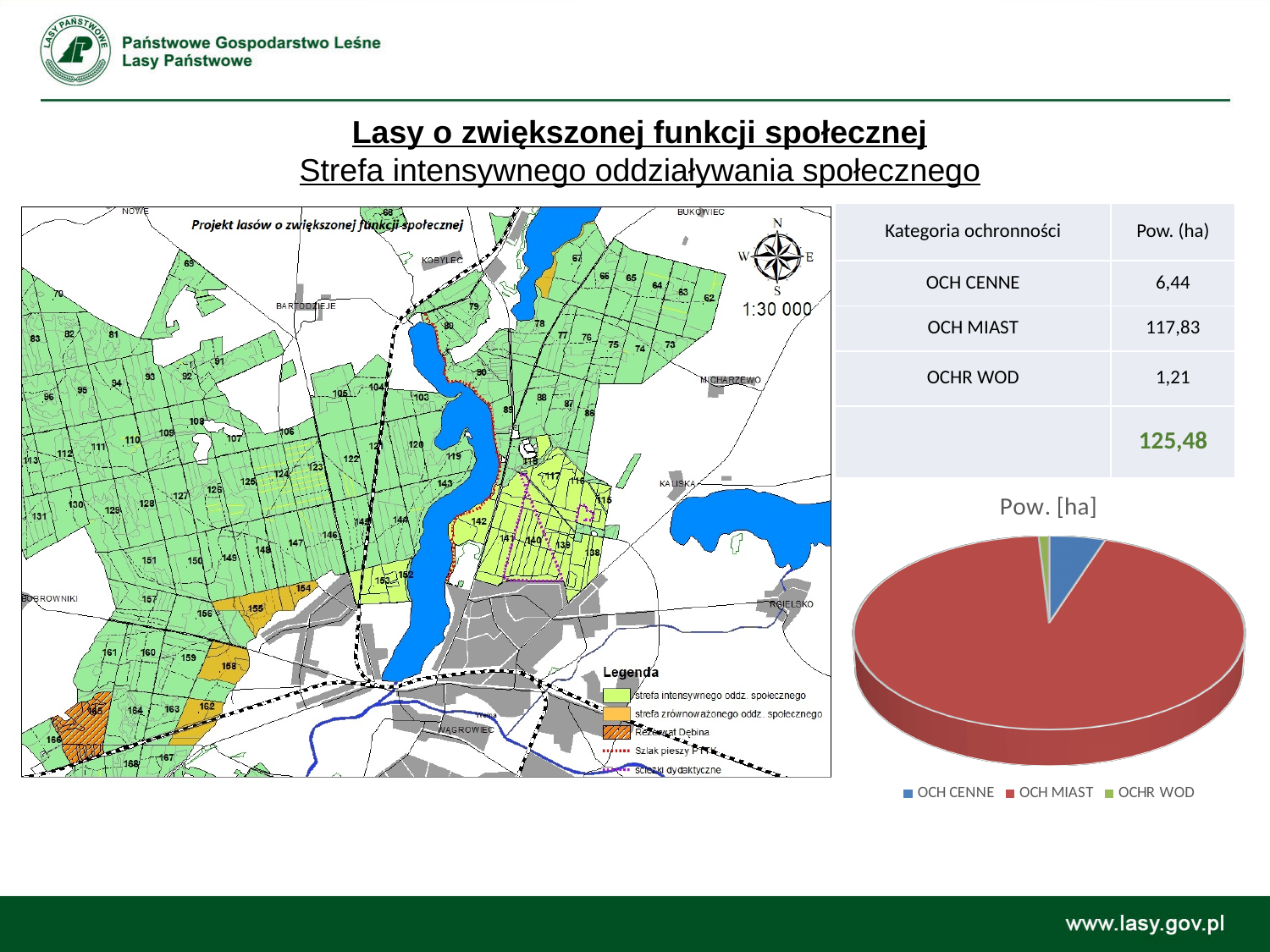
What is the total area (Pow. ha) of all three categories shown on the slide? 125,48 What is the title of the pie chart? Pow. [ha] How many categories does the pie chart legend list? 3 What is the value (Pow. ha) for OCH MIAST shown on the slide? 117,83 What is the value (Pow. ha) for OCHR WOD shown on the slide? 1,21 Which category has the largest slice in the pie chart? OCH MIAST Which category has the smallest slice in the pie chart? OCHR WOD What is the value (Pow. ha) for OCH CENNE shown on the slide? 6,44 What colour is the OCH MIAST slice in the pie chart? red How many slices does the pie chart have? 3 What kind of chart is shown on the slide? pie chart Which is larger in the pie chart, OCH CENNE or OCHR WOD? OCH CENNE